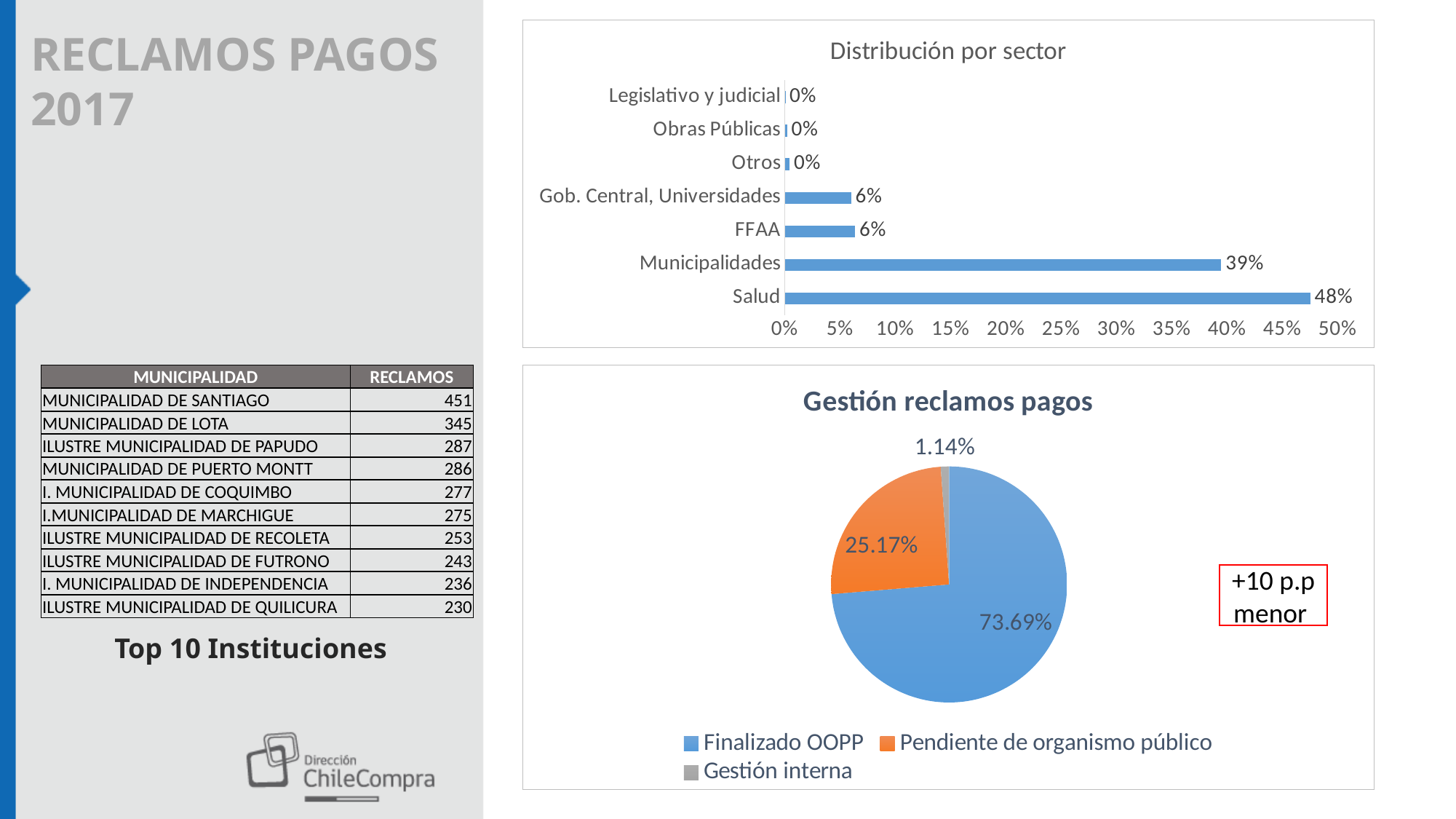
In the 'Distribución por sector' chart, what is the difference between Salud and Municipalidades? 9% In the 'Gestión reclamos pagos' chart, what share does Pendiente de organismo público have? 25.17% In the 'Gestión reclamos pagos' chart, what share does Finalizado OOPP have? 73.69% What kind of chart is 'Distribución por sector'? Bar chart In the 'Distribución por sector' chart, which sector has the highest value? Salud How many entries does the legend of the 'Gestión reclamos pagos' chart list? 3 In the 'Gestión reclamos pagos' chart, which category has the smallest slice? Gestión interna In the 'Distribución por sector' chart, which is larger, Municipalidades or Gob. Central, Universidades? Municipalidades In the 'Distribución por sector' chart, how many sectors are listed? 7 In the 'Distribución por sector' chart, what is the value for Salud? 48% In the 'Distribución por sector' chart, what is the value for Municipalidades? 39% In the 'Distribución por sector' chart, what is the value for FFAA? 6%